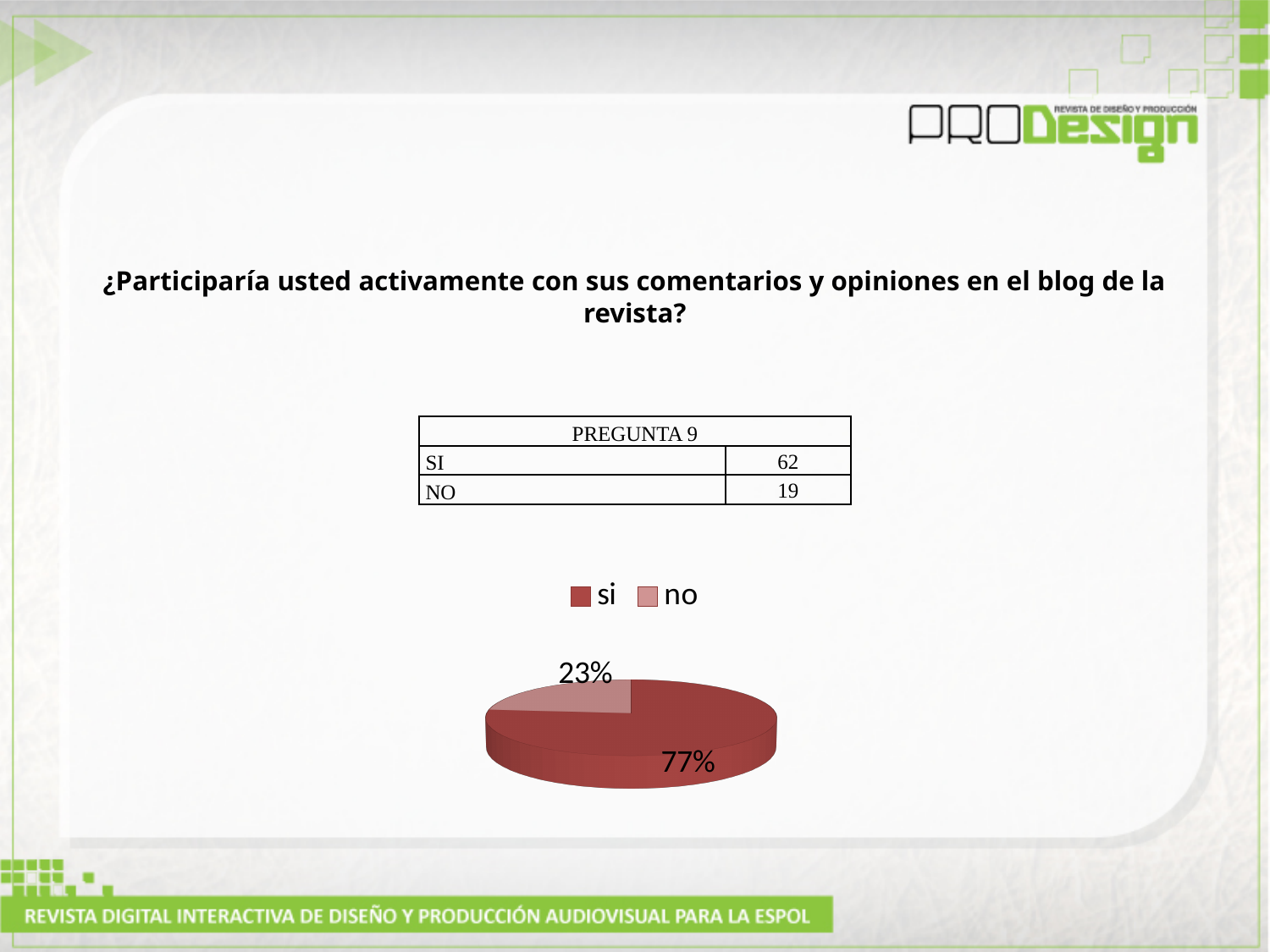
According to the table above the pie chart, how many respondents answered SI? 62 How many slices does the pie chart have? 2 Which legend entry of the pie chart is shown in the darker red colour? si Is the share of the "si" slice in the pie chart greater or less than 50%? greater Which slice of the pie chart is the smallest? no How many entries does the legend of the pie chart list? 2 Which slice of the pie chart is the largest? si What percentage of the pie chart is labelled for the "no" slice? 23% Which slice is larger in the pie chart, "si" or "no"? si What is the difference in percentage points between the "si" and "no" slices of the pie chart? 54 What kind of chart is shown on the slide? pie chart What percentage of the pie chart is labelled for the "si" slice? 77%